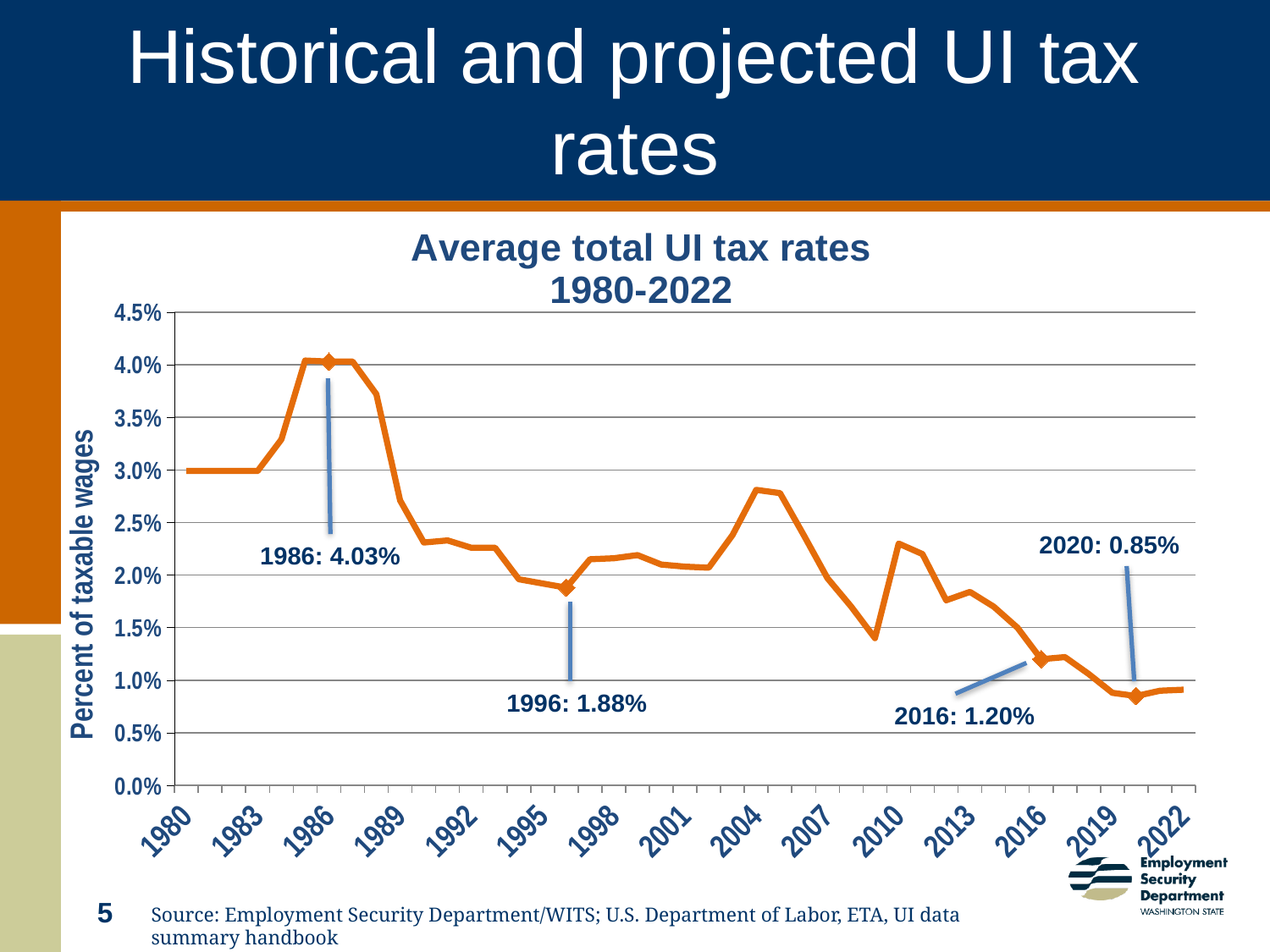
What kind of chart is used to show the average total UI tax rates? Line chart Is the value for 2004 greater or less than 2.5%? greater What is the average total UI tax rate shown for 2016? 1.20% Which labelled year has the higher rate, 1996 or 2016? 1996 What is the average total UI tax rate shown for 2020? 0.85% Is the value for 2010 greater or less than 2.0%? greater Of the four labelled data points, which year has the highest rate? 1986 Of the four labelled data points, which year has the lowest rate? 2020 What is the average total UI tax rate shown for 1996? 1.88% What is the average total UI tax rate shown for 1986? 4.03% By how many percentage points does the labelled 1986 rate exceed the labelled 2020 rate? 3.18 percentage points What is the title of the vertical axis? Percent of taxable wages